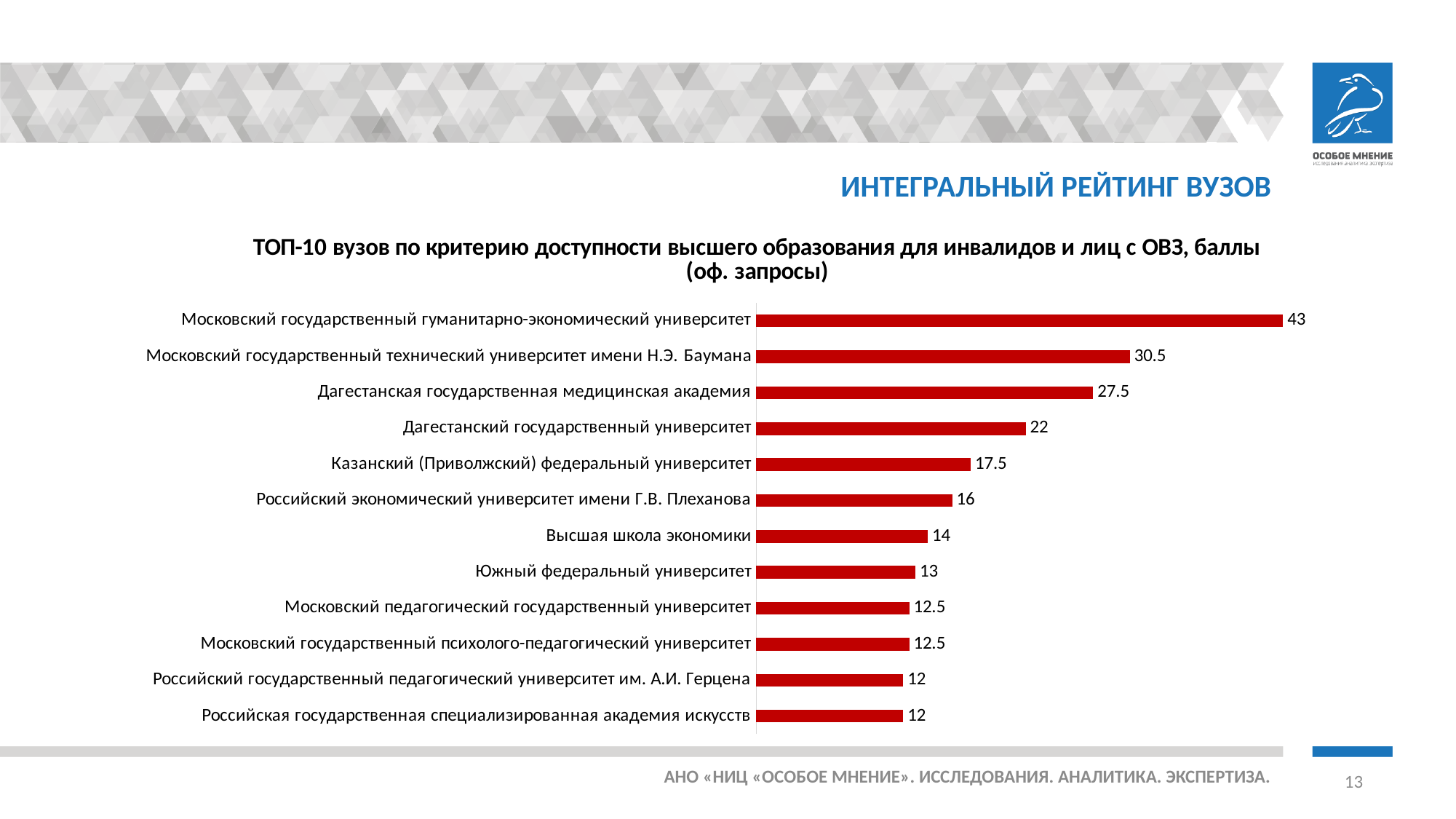
What is the difference between the values for Московский государственный гуманитарно-экономический университет and Дагестанская государственная медицинская академия? 15.5 Which university has the highest value on the chart? Московский государственный гуманитарно-экономический университет What is the difference between the values for Дагестанский государственный университет and Южный федеральный университет? 9 What value is shown for Московский государственный технический университет имени Н.Э. Баумана? 30.5 What is the highest value shown on the chart? 43 Which has a larger value: Российский экономический университет имени Г.В. Плеханова or Московский педагогический государственный университет? Российский экономический университет имени Г.В. Плеханова What is the lowest value shown on the chart? 12 How many universities are shown on the chart? 12 What value is shown for Казанский (Приволжский) федеральный университет? 17.5 What value is shown for Высшая школа экономики? 14 What type of chart is shown on the slide? Bar chart What colour are the bars on the chart? Red